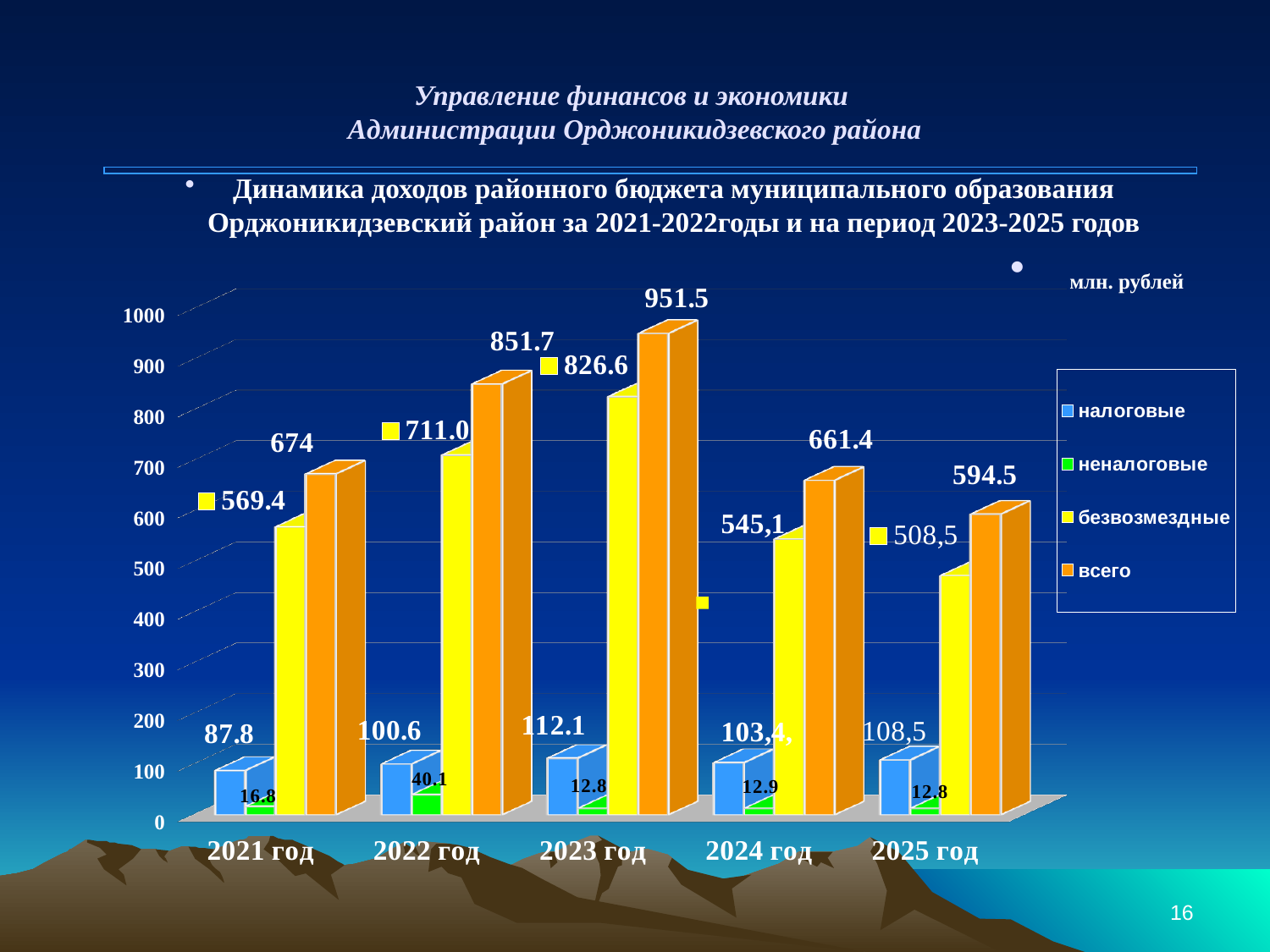
In which year is the неналоговые value the highest? 2022 год How many years are shown on the x axis of the chart? 5 How many series does the chart legend list? 4 What is the value of the безвозмездные series for 2022 год? 711.0 What is the value of the неналоговые series for 2022 год? 40.1 What is the difference between the всего values for 2023 год and 2022 год? 99.8 What kind of chart is shown on the slide? bar chart In which year is the всего value the highest? 2023 год In which year is the всего value the lowest? 2025 год What is the value of the всего series for 2023 год? 951.5 Which year has the larger безвозмездные value, 2021 год or 2025 год? 2021 год What is the value of the налоговые series for 2021 год? 87.8